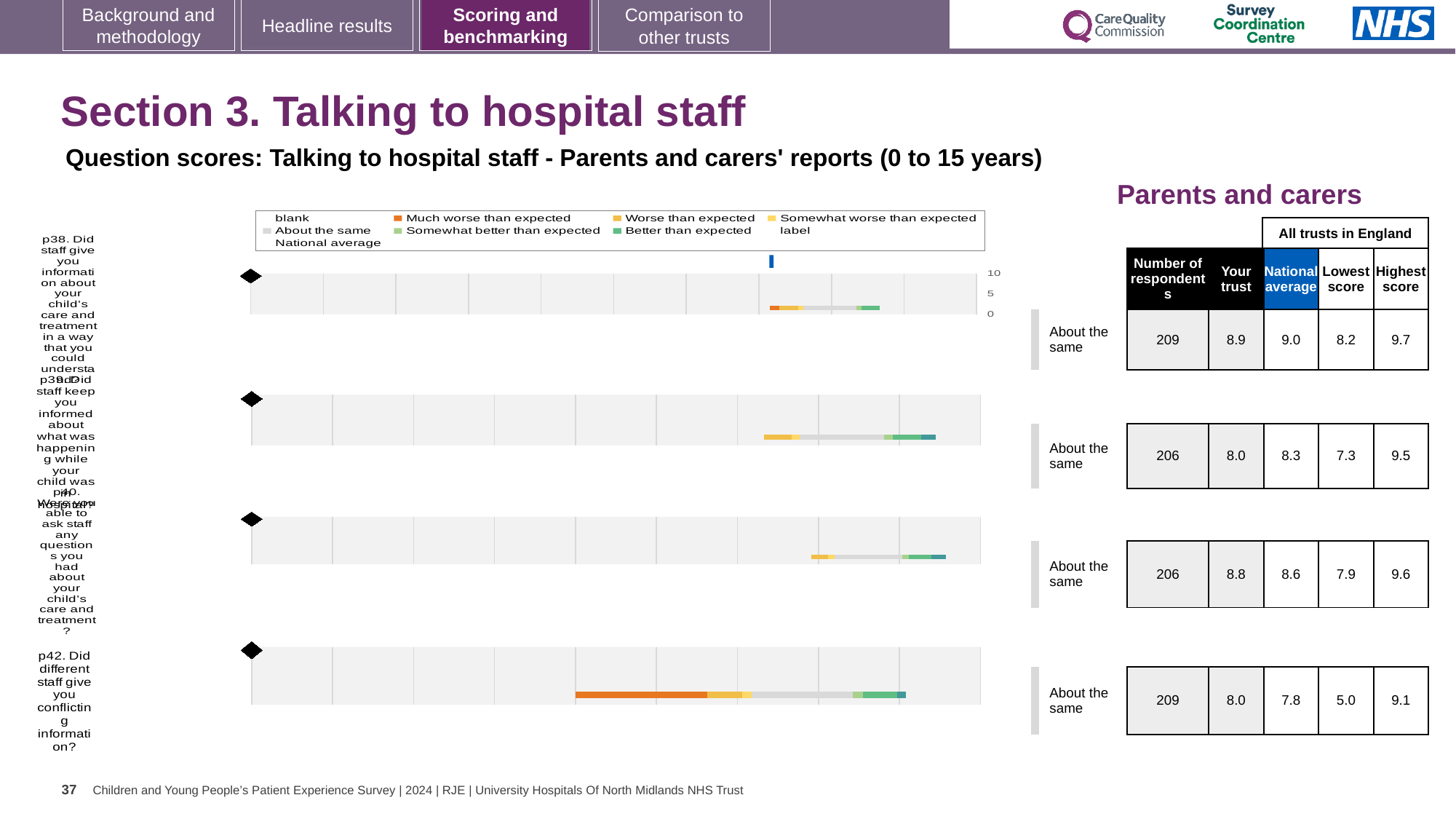
For question p40, which is larger: the 'Your trust' score or the national average? Your trust Which colour in the legend represents 'Much worse than expected'? Orange What is the 'Your trust' score for question p38 (Did staff give you information about your child's care and treatment in a way that you could understand)? 8.9 What benchmark category is shown for question p42? About the same What kind of chart is used to show the question scores on this slide? bar chart What is the lowest score among all trusts in England for question p42 (Did different staff give you conflicting information)? 5.0 Which question has the lowest 'Lowest score' across all trusts in England? p42 What is the difference between the highest score (9.7) and the lowest score (8.2) for question p38? 1.5 What is the national average score for question p39 (Did staff keep you informed about what was happening while your child was in hospital)? 8.3 Which question has the highest 'Your trust' score? p38 How many survey questions (p38, p39, p40, p42) are plotted on the slide? 4 How many respondents answered question p40 (Were you able to ask staff any questions you had about your child's care and treatment)? 206